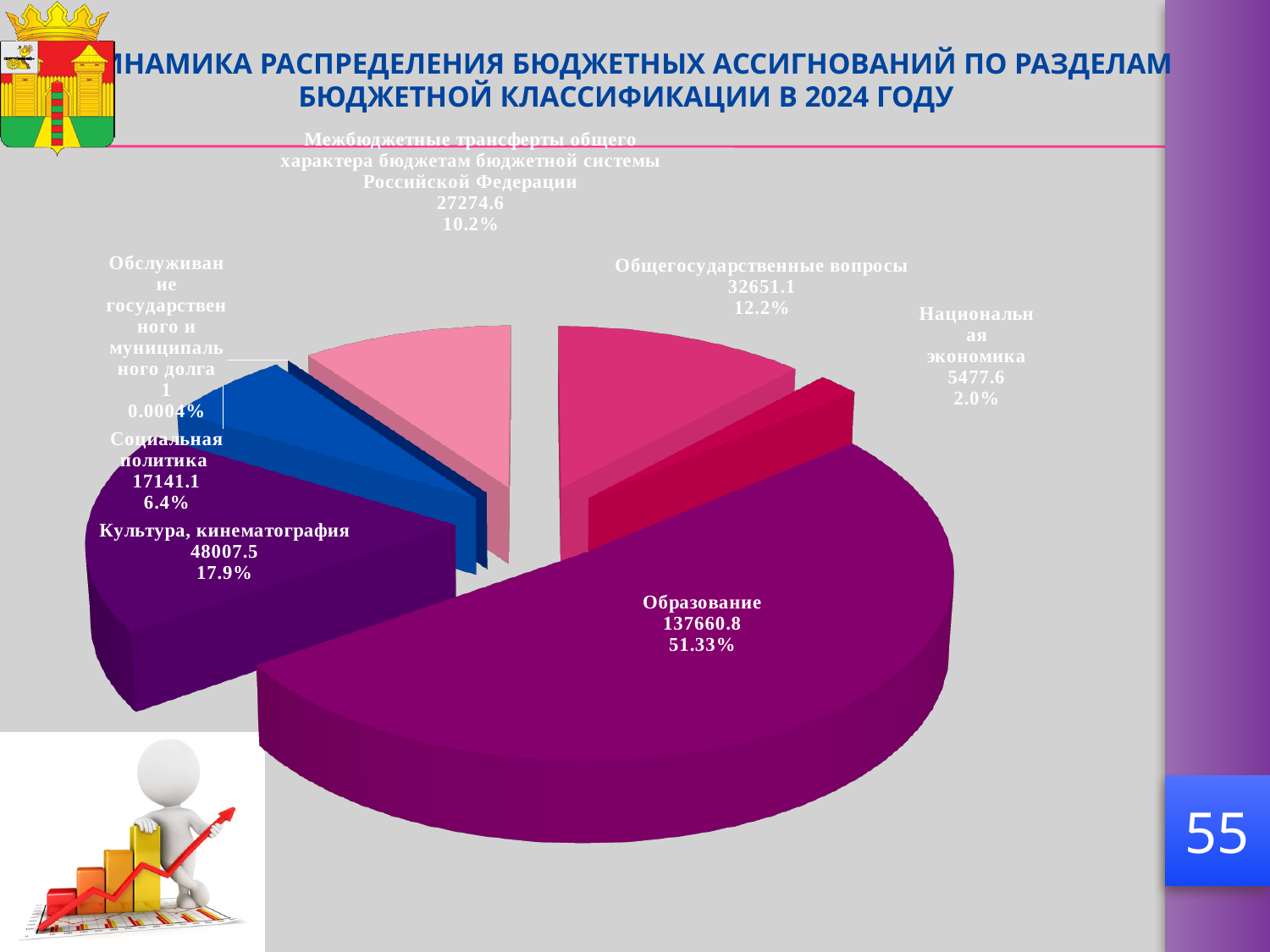
Which is larger: Общегосударственные вопросы or Межбюджетные трансферты общего характера бюджетам бюджетной системы Российской Федерации? Общегосударственные вопросы What share of the pie does Национальная экономика represent? 2.0% What is the value for Образование? 137660.8 What is the difference between the values for Образование and Культура, кинематография? 89653.3 How many categories (slices) does the pie chart show? 7 What kind of chart is shown on the slide? pie chart What share of the pie does Образование represent? 51.33% What share of the pie does Социальная политика represent? 6.4% Which category has the largest slice of the pie? Образование What is the value for Общегосударственные вопросы? 32651.1 Which category has the smallest slice of the pie? Обслуживание государственного и муниципального долга What is the value for Культура, кинематография? 48007.5